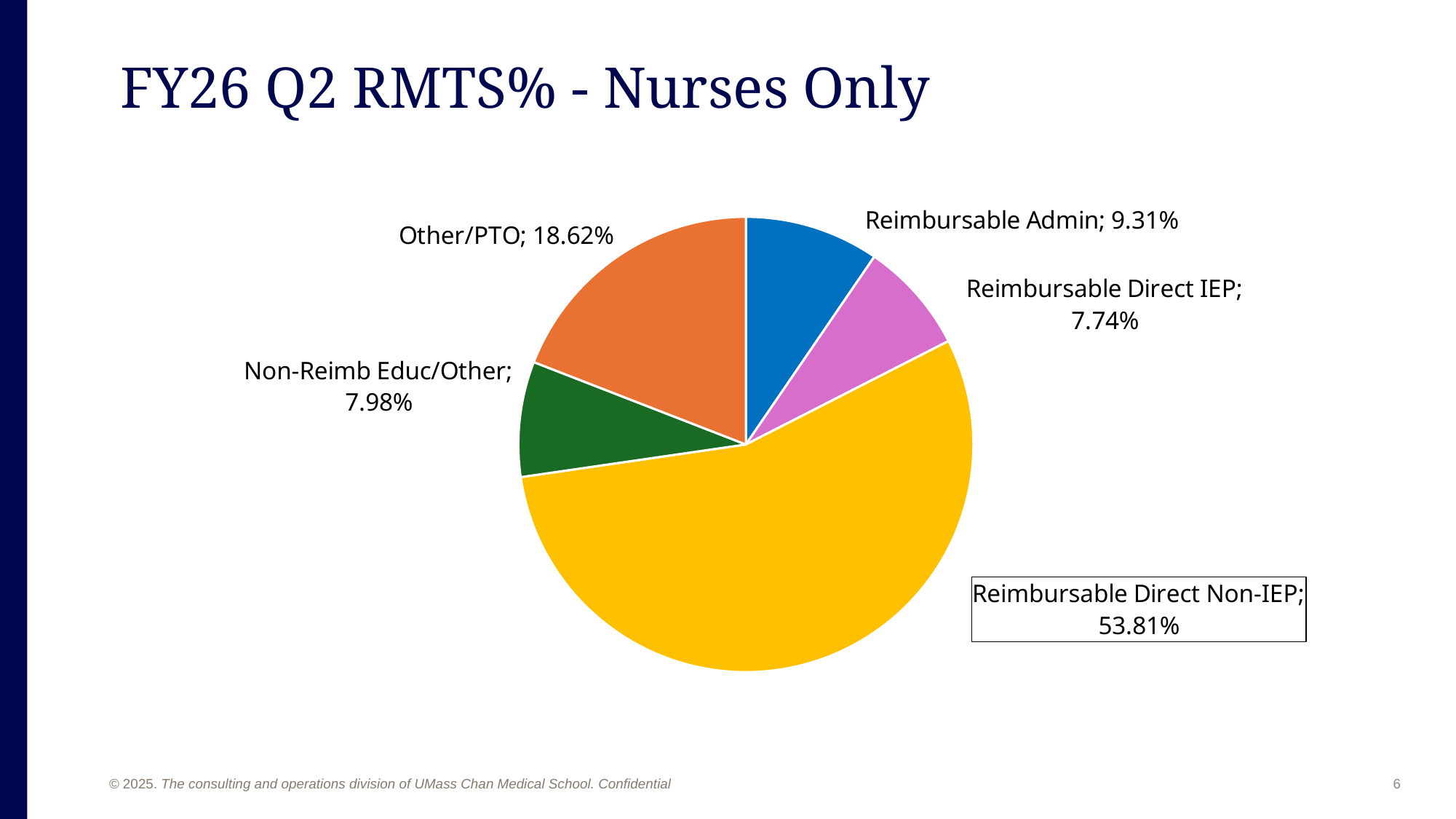
What is the difference between the Other/PTO share and the Reimbursable Admin share? 9.31% What is the share for Other/PTO? 18.62% Which is larger, the share for Reimbursable Admin or the share for Non-Reimb Educ/Other? Reimbursable Admin What is the share for Non-Reimb Educ/Other? 7.98% How many slices does the pie chart have? 5 What is the share for Reimbursable Admin? 9.31% What is the share for Reimbursable Direct Non-IEP? 53.81% What is the title of the chart on the slide? FY26 Q2 RMTS% - Nurses Only Which category has the smallest slice of the pie? Reimbursable Direct IEP Which category has the largest slice of the pie? Reimbursable Direct Non-IEP What kind of chart is shown on the slide? Pie chart What is the share for Reimbursable Direct IEP? 7.74%